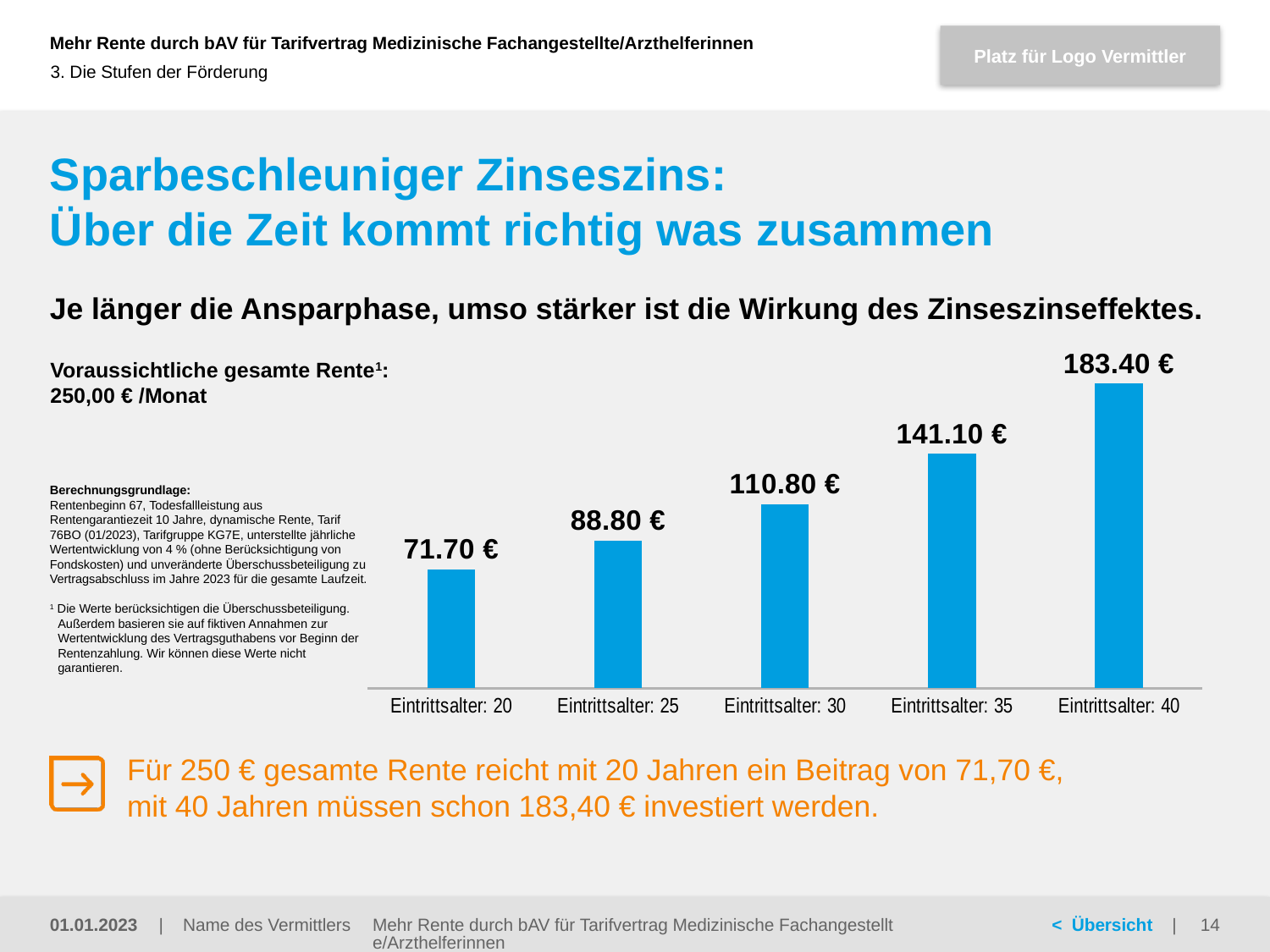
What is the difference between the values for Eintrittsalter: 35 and Eintrittsalter: 30? 30.30 € What is the difference between the values for Eintrittsalter: 40 and Eintrittsalter: 20? 111.70 € Do the values rise or fall as the Eintrittsalter increases along the x axis? Rise What colour are the bars in the chart? Blue What kind of chart is shown on the slide? Bar chart Which is larger, the value for Eintrittsalter: 25 or the value for Eintrittsalter: 35? Eintrittsalter: 35 What is the value shown for Eintrittsalter: 35? 141.10 € Which category has the highest value? Eintrittsalter: 40 What is the value shown for Eintrittsalter: 30? 110.80 € Which category has the lowest value? Eintrittsalter: 20 How many categories are shown on the x axis? 5 What is the value shown for Eintrittsalter: 20? 71.70 €